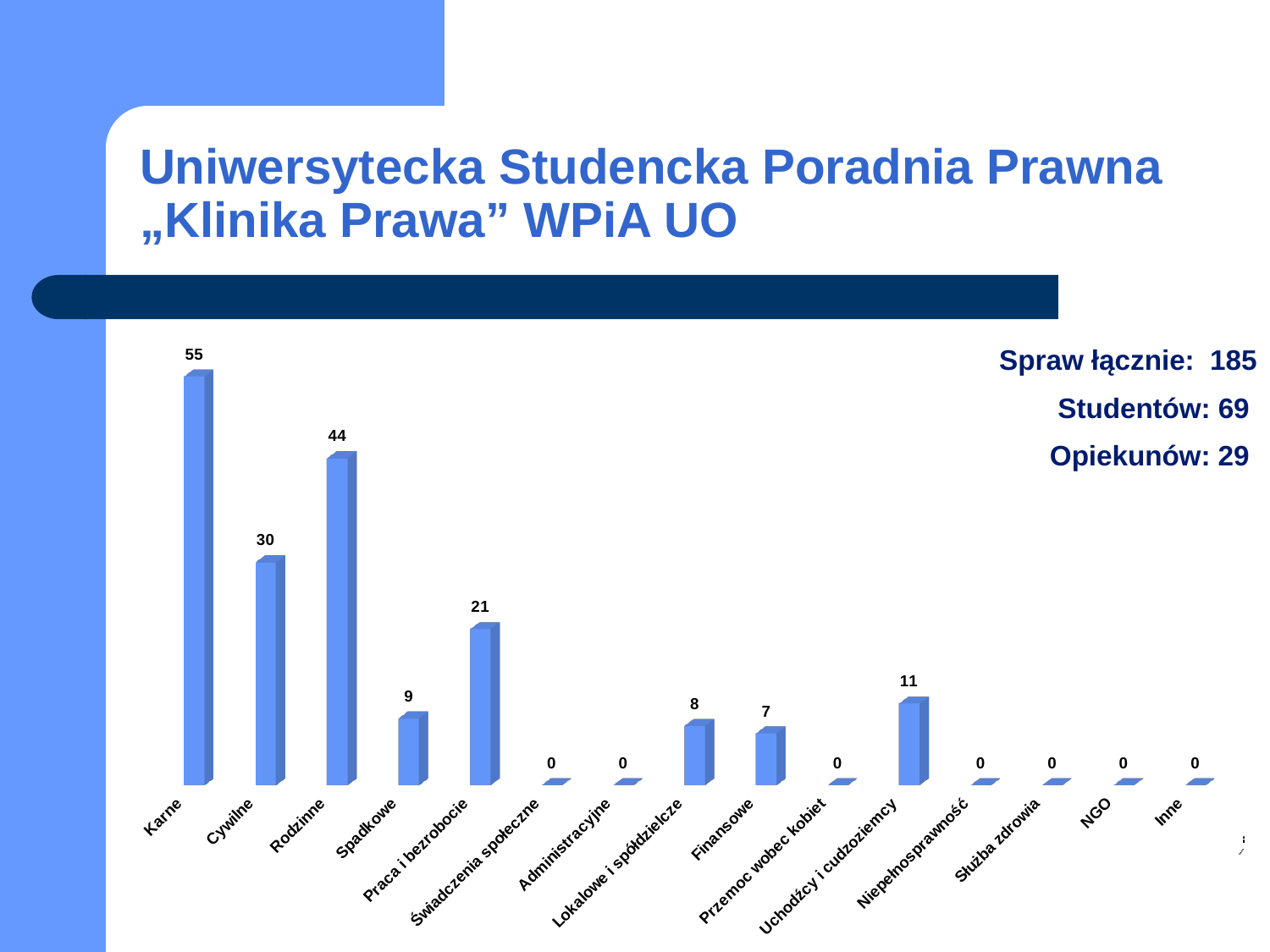
What is the value for Karne? 55 How many categories are shown on the x axis of the chart? 15 Which category has the highest value? Karne What is the value for Praca i bezrobocie? 21 What is the difference between the values for Cywilne and Praca i bezrobocie? 9 What is the value for Uchodźcy i cudzoziemcy? 11 What is the difference between the values for Karne and Rodzinne? 11 Which is larger, the value for Cywilne or the value for Rodzinne? Rodzinne What kind of chart is shown on the slide? bar chart Which is larger, the value for Lokalowe i spółdzielcze or the value for Finansowe? Lokalowe i spółdzielcze What is the value for Rodzinne? 44 What is the value for Spadkowe? 9